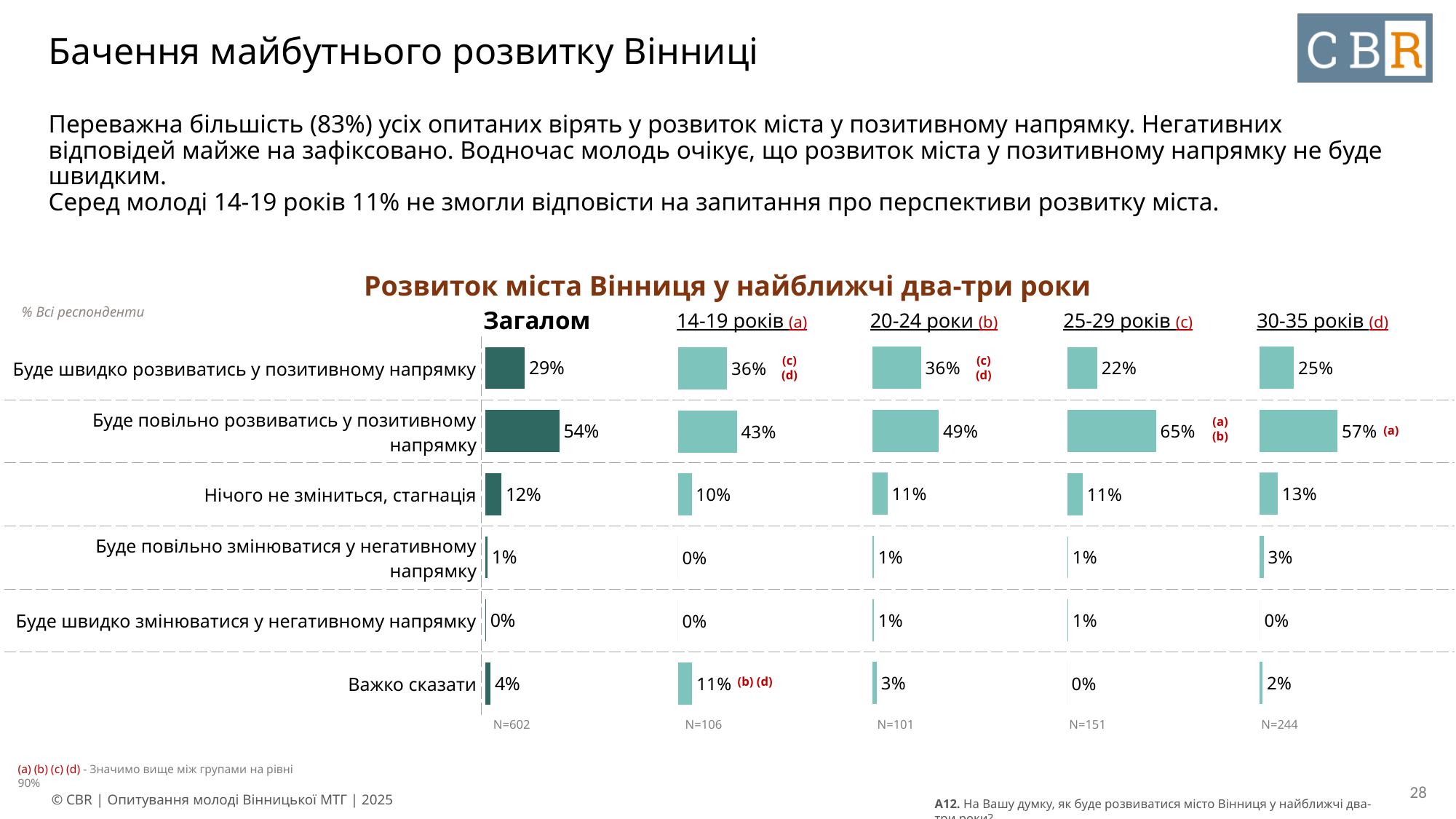
In the "14-19 років" chart, what is the difference between "Буде повільно розвиватись у позитивному напрямку" and "Буде швидко розвиватись у позитивному напрямку"? 7% In the "25-29 років" chart, which category has the highest value? Буде повільно розвиватись у позитивному напрямку What is the sample size (N) shown under the "30-35 років" chart? N=244 In the "30-35 років" chart, what is the value for "Буде повільно змінюватися у негативному напрямку"? 3% In the "20-24 роки" chart, which category has the highest value? Буде повільно розвиватись у позитивному напрямку In the "25-29 років" chart, what is the value for "Буде швидко розвиватись у позитивному напрямку"? 22% In the "14-19 років" chart, what is the value for "Важко сказати"? 11% In the "Загалом" chart, what is the difference between "Буде повільно розвиватись у позитивному напрямку" and "Буде швидко розвиватись у позитивному напрямку"? 25% In the "Загалом" chart, what is the value for "Буде повільно розвиватись у позитивному напрямку"? 54% How many categories are shown in the "Загалом" chart? 6 What kind of chart is used for the "Загалом" data? Bar chart Which is larger: the value for "Буде повільно розвиватись у позитивному напрямку" in the "25-29 років" chart or in the "30-35 років" chart? 25-29 років